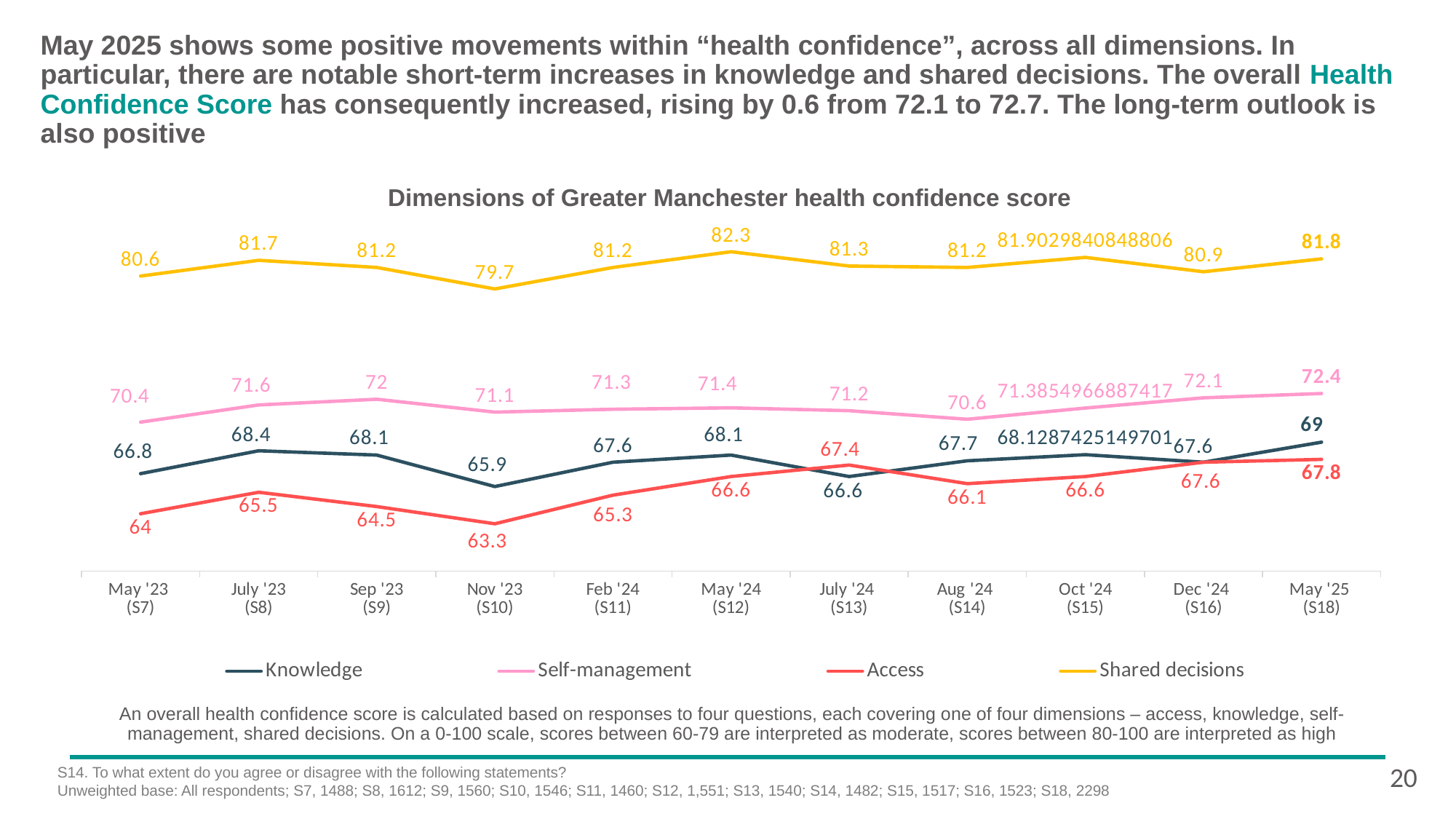
What kind of chart is shown on the slide? Line chart What is the title of the chart? Dimensions of Greater Manchester health confidence score What is the Shared decisions score for May '25 (S18)? 81.8 What is the Access score for Nov '23 (S10)? 63.3 How many series does the legend list? 4 At which time point is the Shared decisions score highest? May '24 (S12) By how much did the Knowledge score change from Dec '24 (S16) to May '25 (S18)? 1.4 In July '24 (S13), which is higher: the Knowledge score or the Access score? Access What is the difference between the Shared decisions score in May '24 (S12) and Nov '23 (S10)? 2.6 What is the Self-management score for Sep '23 (S9)? 72 At which time point is the Access score lowest? Nov '23 (S10) How many time points are plotted along the x axis? 11